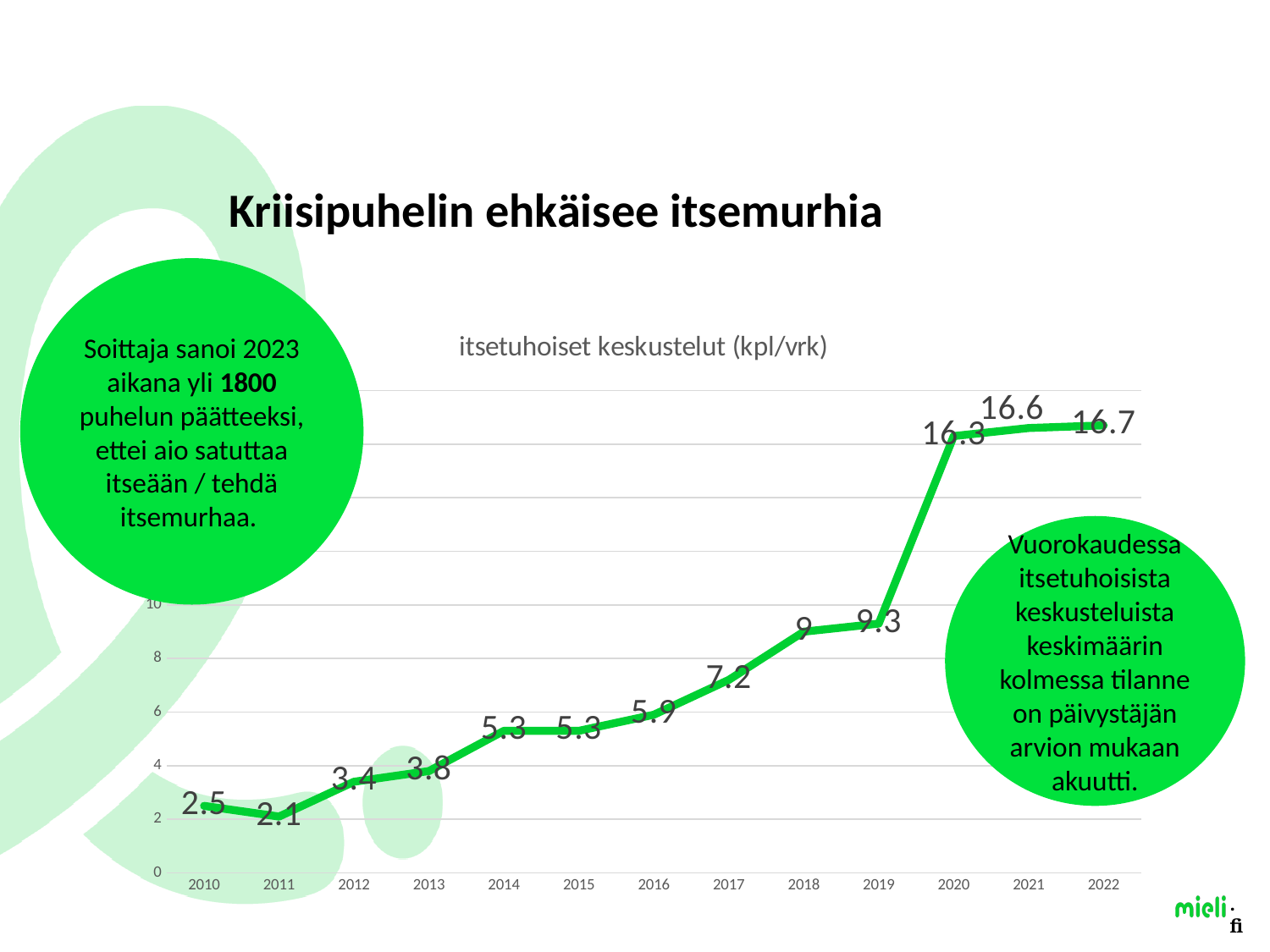
Which year has the lowest value? 2011 What is the value for 2020? 16.3 Which year has the highest value? 2022 What is the value for 2017? 7.2 What type of chart is shown on the slide? line chart How many years are plotted on the x axis? 13 What is the value for 2010? 2.5 What is the title of the chart? itsetuhoiset keskustelut (kpl/vrk) What is the difference between the values for 2020 and 2019? 7 Do the values generally rise or fall from 2010 to 2022? rise Is the value for 2018 greater or less than 8? greater Which is larger, the value for 2013 or the value for 2016? 2016